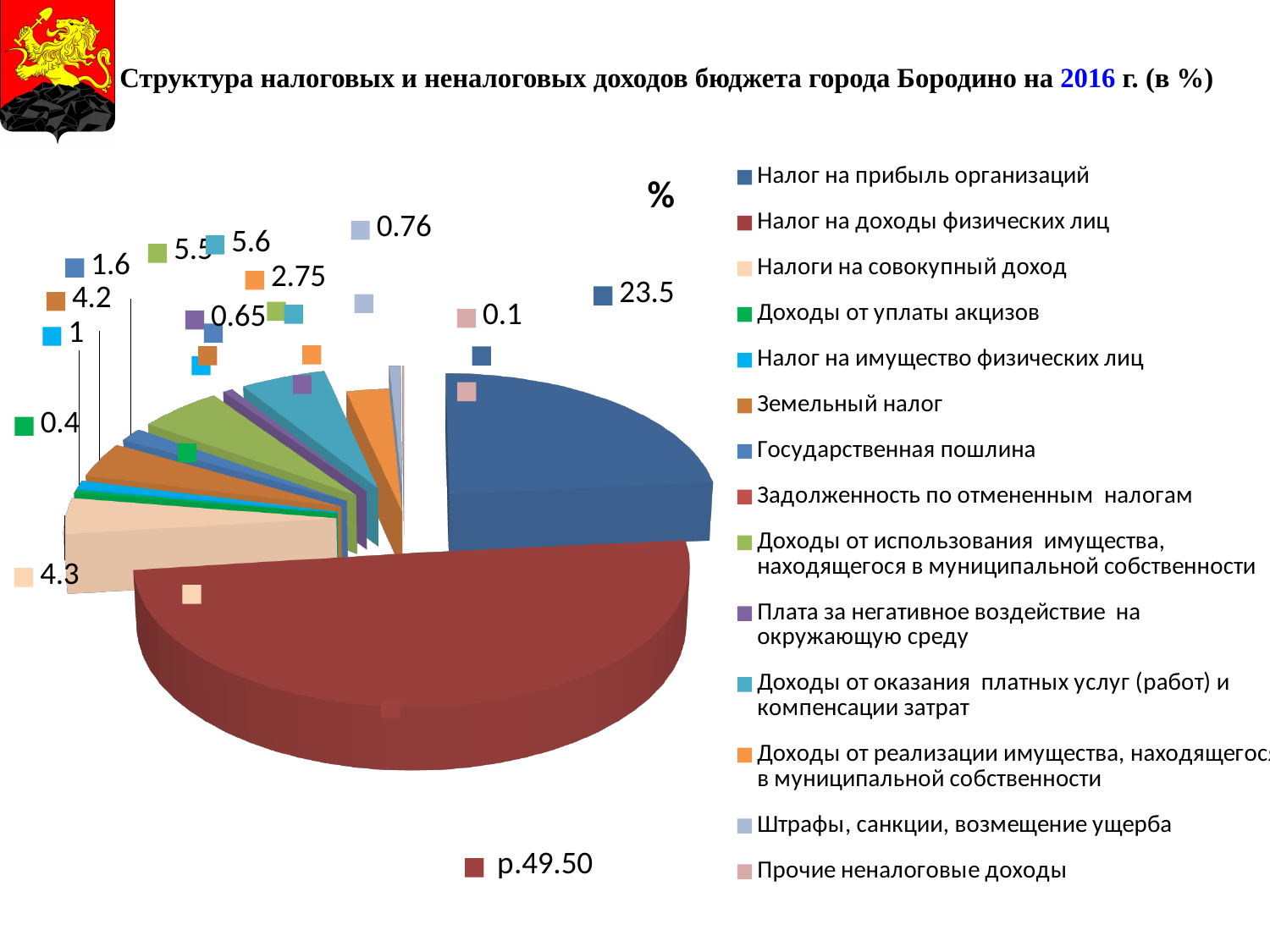
What value is shown for Налог на прибыль организаций? 23.5 What is the difference between the values for Налог на прибыль организаций and Налоги на совокупный доход? 19.2 Which category has the largest share of the pie? Налог на доходы физических лиц How many categories does the legend of the pie chart list? 14 Which is larger: Налог на прибыль организаций or Налоги на совокупный доход? Налог на прибыль организаций What value is shown for Налоги на совокупный доход? 4.3 What type of chart is shown on the slide? Pie chart Which year does the chart title say the budget income structure refers to? 2016 What value is shown for Государственная пошлина? 1.6 What value is shown for Прочие неналоговые доходы? 0.1 What value is shown for Земельный налог? 4.2 What value is shown for Штрафы, санкции, возмещение ущерба? 0.76